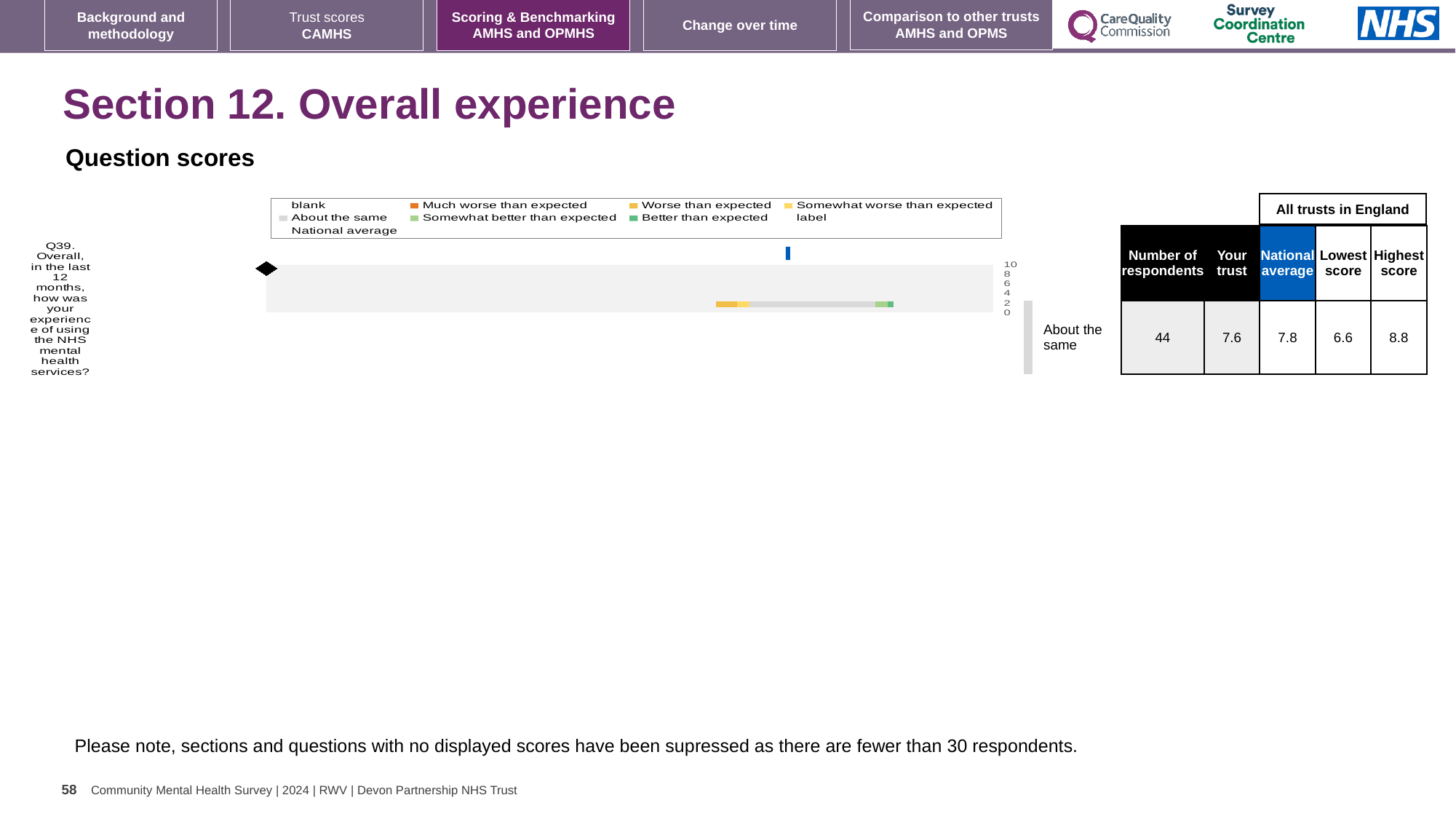
Which question is plotted on the chart? Q39. Overall, in the last 12 months, how was your experience of using the NHS mental health services? Which benchmark category does the trust's Q39 score fall into? About the same What is the highest score among all trusts in England for Q39? 8.8 Which is larger for Q39, the 'Your trust' score or the national average? National average What is the lowest score among all trusts in England for Q39? 6.6 What kind of chart is shown on the slide? bar chart What is the difference between the highest score and the lowest score for Q39? 2.2 What is the national average score for Q39? 7.8 How many questions (categories) are plotted on the chart? 1 How many respondents answered Q39? 44 What is the maximum value shown on the chart's score axis? 10 What is the 'Your trust' score for Q39? 7.6